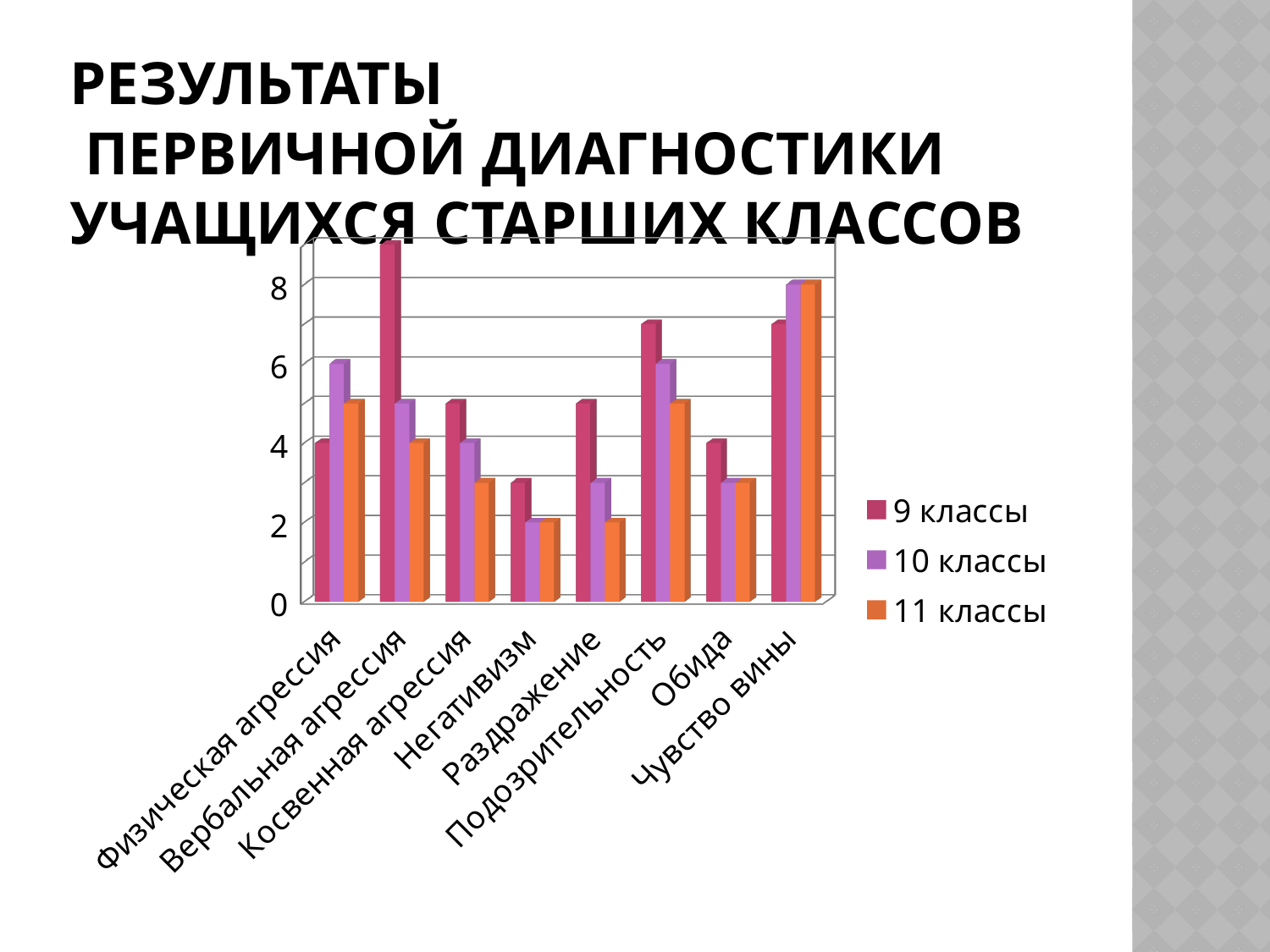
Is the value for Негативизм in the 10 классы series greater or less than 4? less How many series does the chart legend list? 3 Which category has the lowest value for the 9 классы series? Негативизм Is the value for Обида in the 11 классы series greater or less than 4? less What kind of chart is shown on the slide? bar chart Is the value for Вербальная агрессия in the 9 классы series greater or less than 8? greater For Физическая агрессия, which series has the larger value: 9 классы or 10 классы? 10 классы How many categories are shown along the x axis of the chart? 8 What are the three series listed in the chart legend? 9 классы, 10 классы, 11 классы For Раздражение, which series has the larger value: 9 классы or 11 классы? 9 классы Which category has the highest value for the 9 классы series? Вербальная агрессия